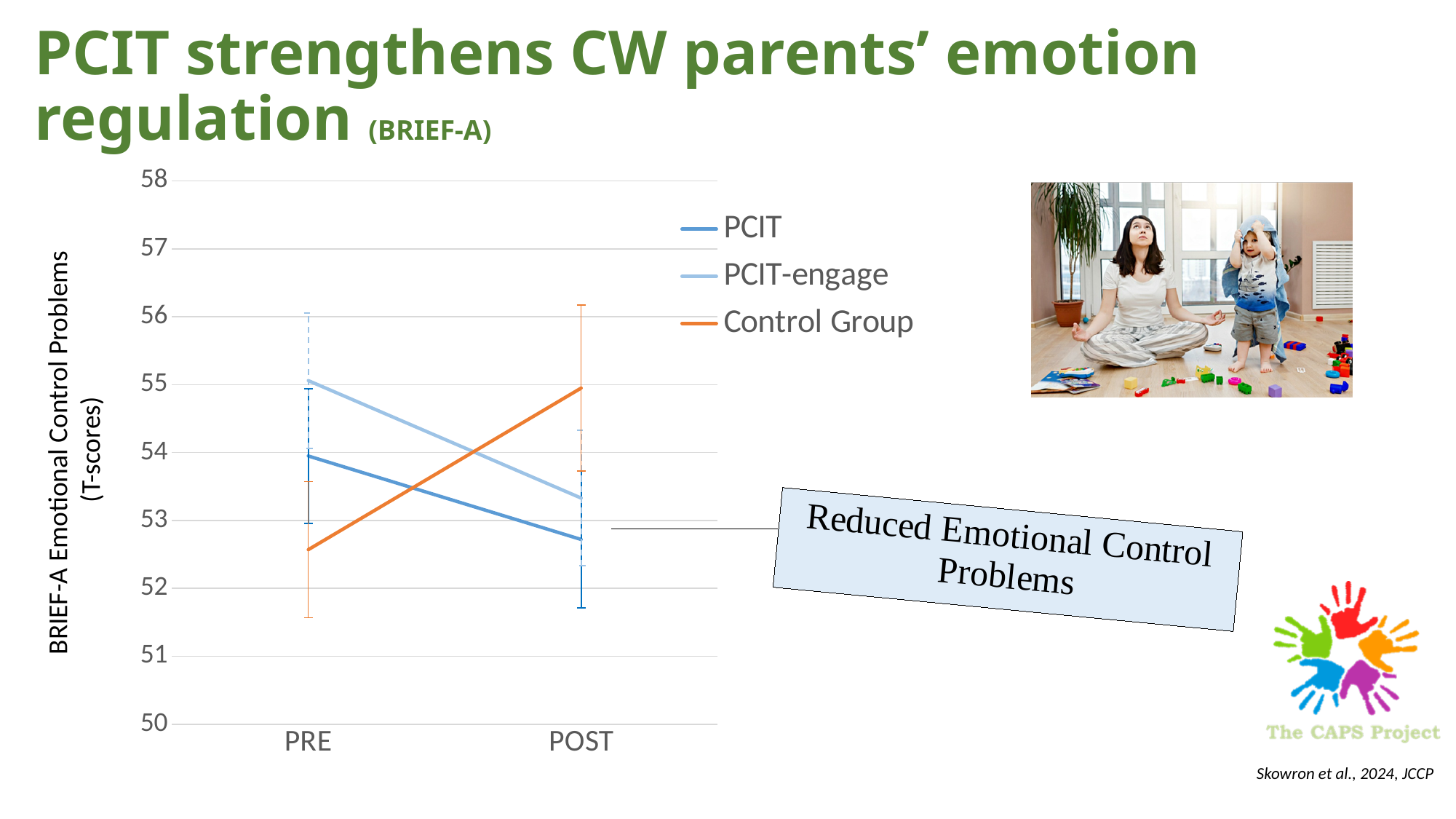
Which group has the highest BRIEF-A Emotional Control Problems score at PRE? PCIT-engage Is the PCIT-engage value at PRE greater or less than 54? greater What is the label on the y axis of the chart? BRIEF-A Emotional Control Problems (T-scores) How many series does the legend list? 3 What kind of chart is shown on the slide? Line chart How many time points are shown on the x axis? 2 Which group has the highest score at POST? Control Group Which group has the lowest BRIEF-A Emotional Control Problems score at PRE? Control Group Is the Control Group's value at PRE greater or less than 53? less Does the PCIT group's score rise or fall from PRE to POST? Fall Does the Control Group's score rise or fall from PRE to POST? Rise Which group has the lowest score at POST? PCIT